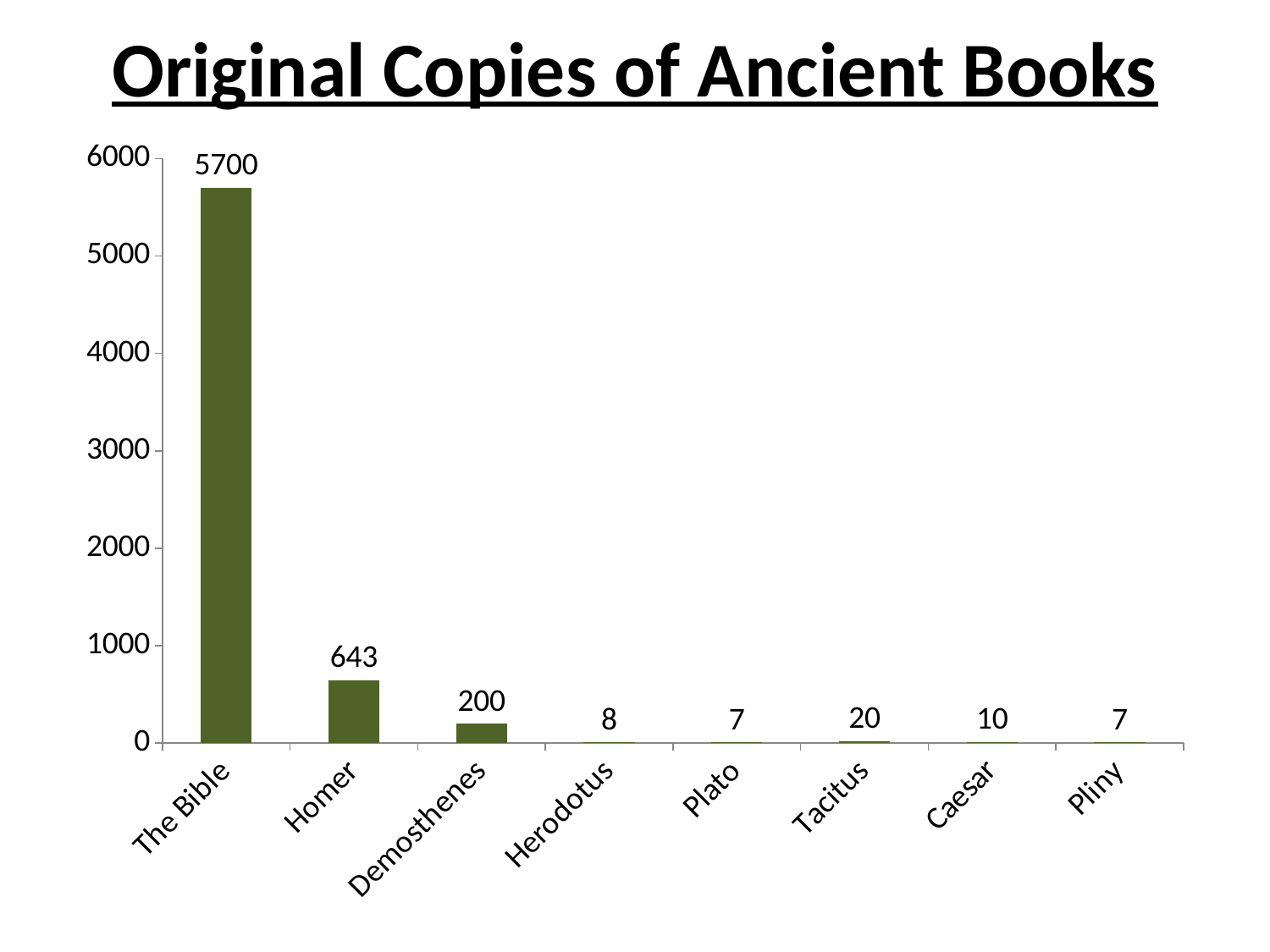
How many categories are shown on the x axis? 8 What is the difference between the values for The Bible and Homer? 5057 Which is larger, the value for Herodotus or the value for Plato? Herodotus What is the value for The Bible? 5700 What kind of chart is this? Bar chart What is the value for Demosthenes? 200 What is the value for Homer? 643 What is the title of the chart? Original Copies of Ancient Books What is the difference between the values for Tacitus and Caesar? 10 What is the value for Tacitus? 20 Which category has the highest value? The Bible What is the value for Caesar? 10